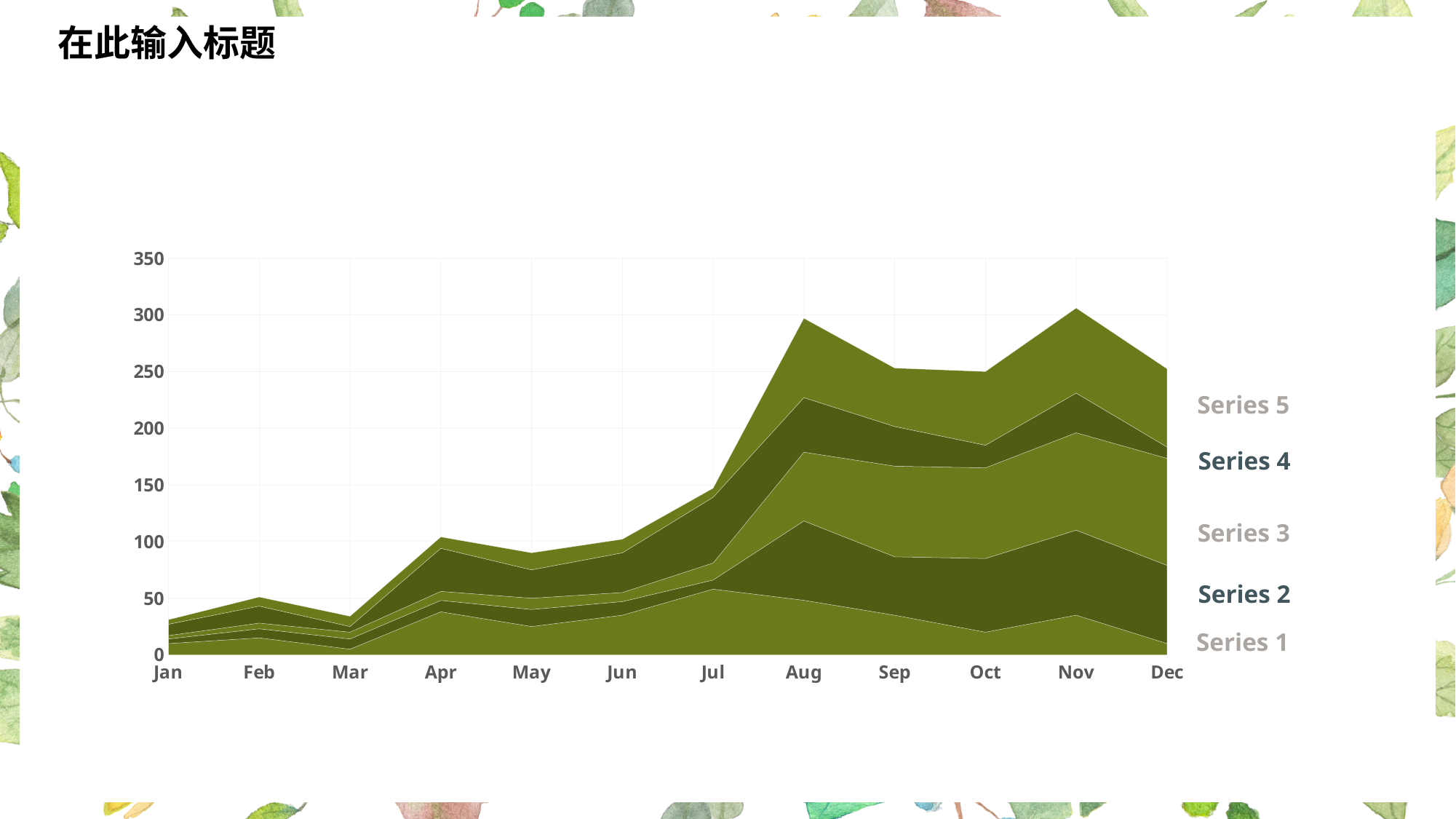
What kind of chart is shown on the slide? stacked area chart How many categories (months) are shown on the x axis? 12 Is the stacked total for Feb greater or less than 100? less Which has the larger stacked total, Dec or Mar? Dec Is the stacked total for Jan greater or less than 50? less Does the stacked total generally rise or fall from Mar to Aug? rise Which has the larger stacked total, Aug or Feb? Aug Is the stacked total for Aug greater or less than 250? greater How many series does the legend list? 5 What is the name of the top series in the legend? Series 5